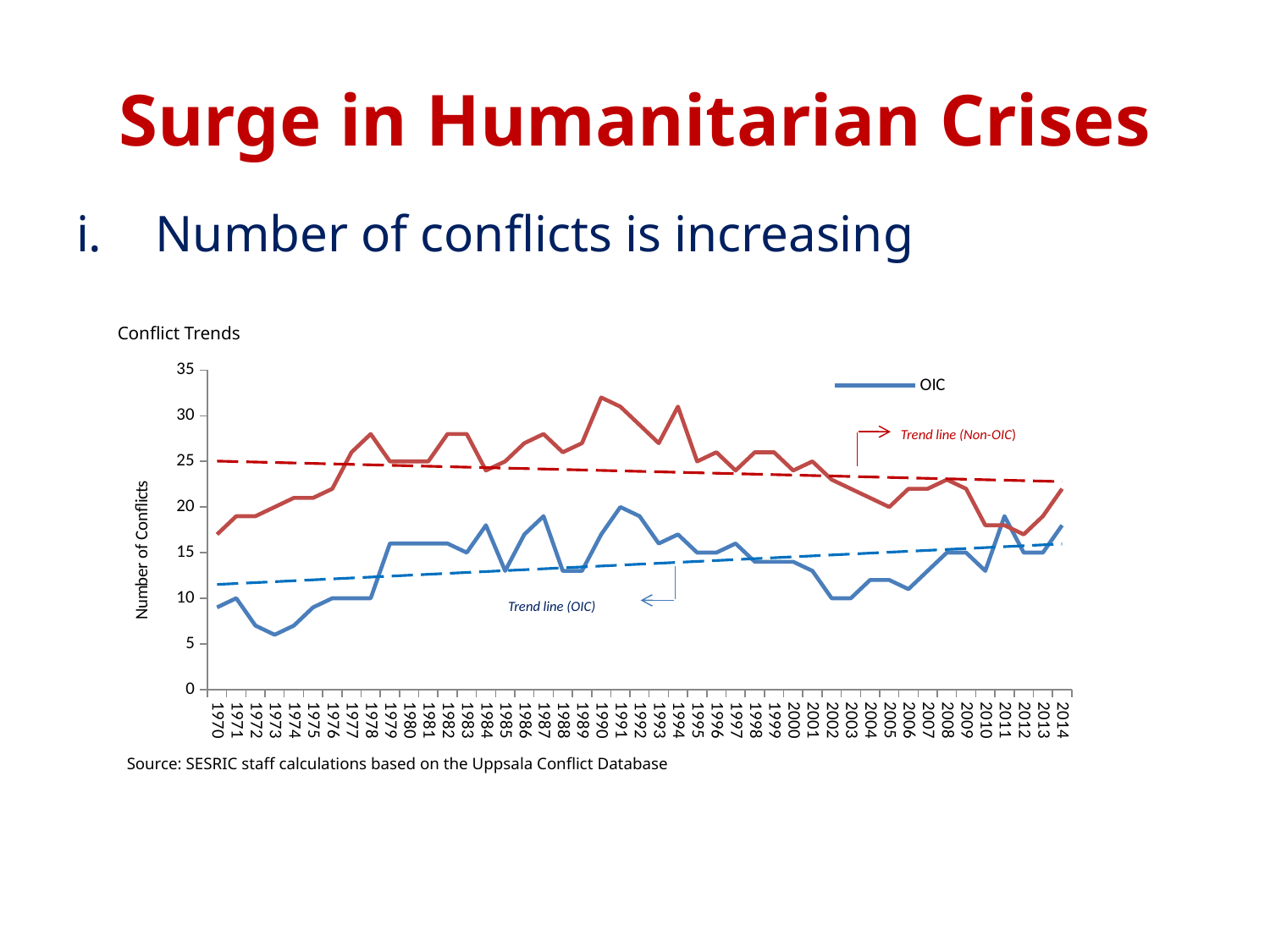
What is the title of the chart? Conflict Trends Is the OIC value for 1973 greater or less than 10? less Is the Non-OIC value for 2012 greater or less than 20? less Is the Non-OIC value for 1990 greater or less than 30? greater What is the label on the vertical axis of the chart? Number of Conflicts Does the Non-OIC trend line rise or fall from 1970 to 2014? Falls Does the OIC trend line rise or fall from 1970 to 2014? Rises In 1991, which line is higher, the OIC line or the Non-OIC line? Non-OIC Which year has the lowest value on the OIC line? 1973 What kind of chart is shown on the slide? Line chart